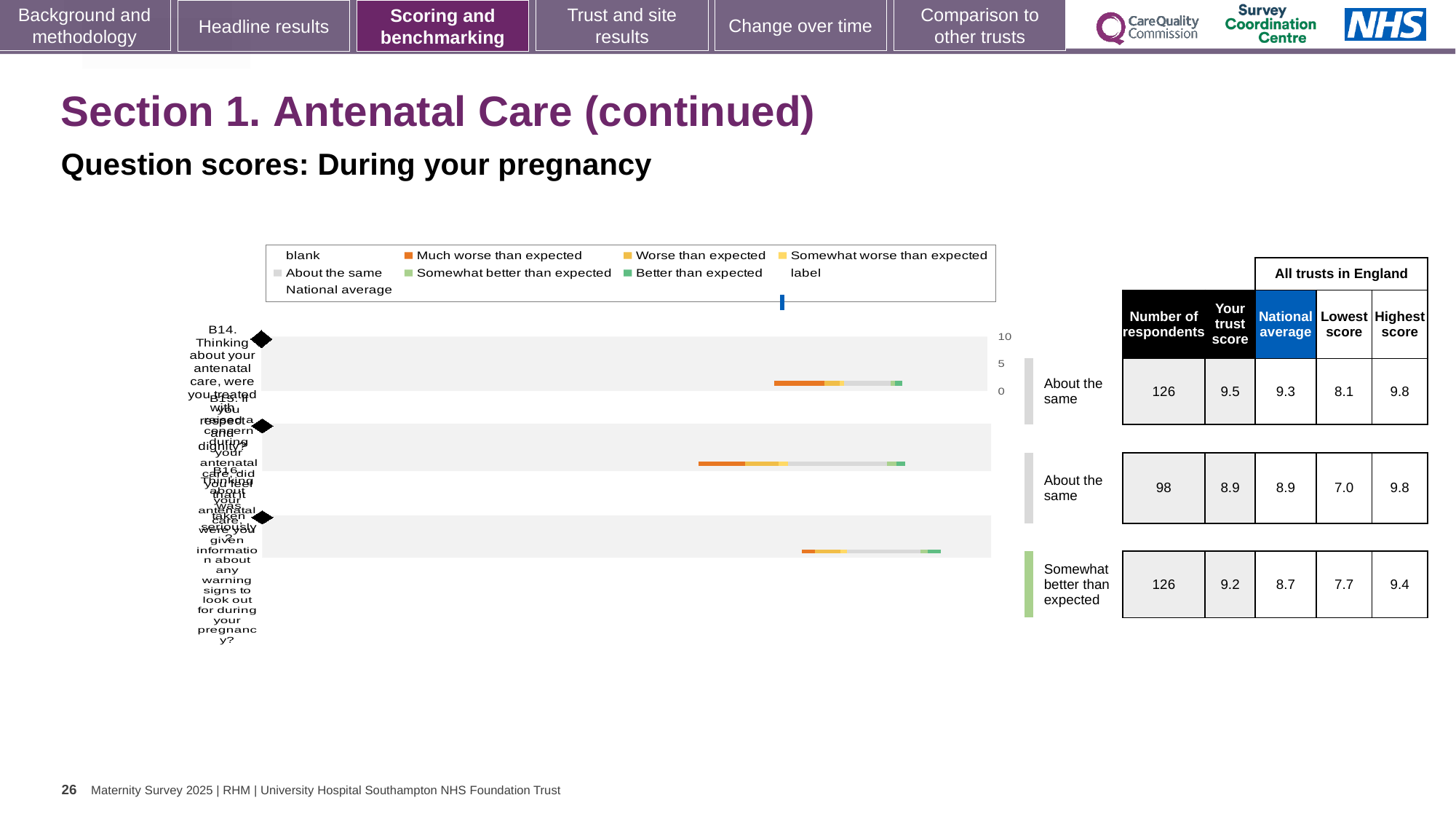
In the table next to the chart, what is the national average for the third row? 8.7 How many question rows (bars) are plotted in the chart? 3 In the chart legend, what colour represents 'Much worse than expected'? orange In the table, for the third row, which is larger: 'Your trust score' or the national average? Your trust score In the table next to the chart, what is 'Your trust score' for the second row? 8.9 In the chart legend, what colour represents 'Better than expected'? green In the table, what is the difference between the highest score and the lowest score for the first row? 1.7 What kind of chart is shown on the slide? bar chart In the table, which row has the lowest 'Lowest score'? the second row (7.0) In the table, which row has the highest 'Your trust score'? the first row (9.5) In the table next to the chart, what is the number of respondents for the first row? 126 What benchmark category is shown for the third row of the table? Somewhat better than expected